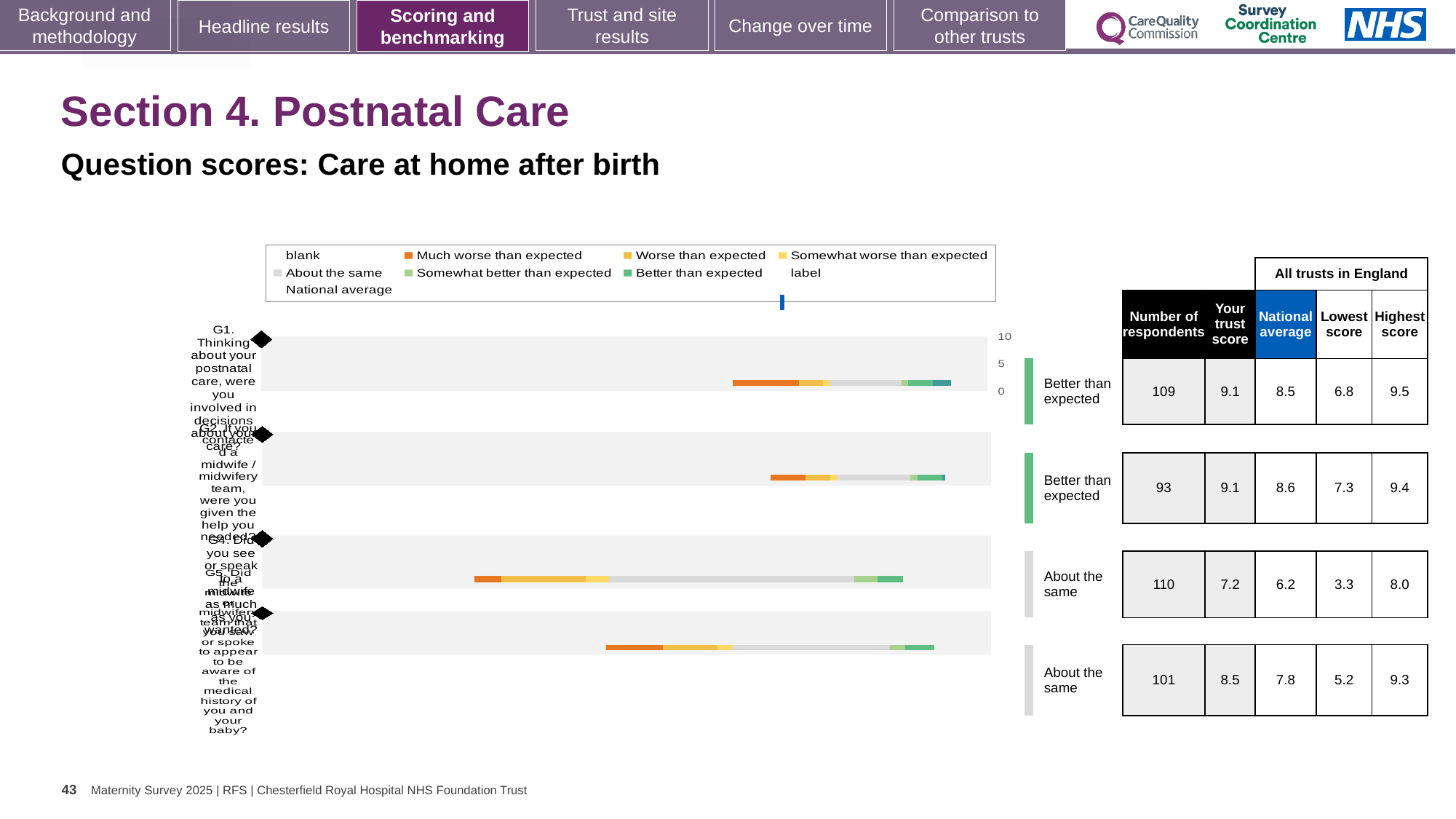
Which is larger for the fourth question row: the trust score or the national average? the trust score (8.5) What benchmark category is shown for the first two question rows? Better than expected What is the difference between the trust score and the national average for the third question row? 1.0 What kind of chart is shown on the slide? bar chart What is the lowest score across all trusts in England for the fourth (bottom) question row? 5.2 What is the difference between the highest and lowest scores for the third question row? 4.7 How many respondents are listed for the third question row? 110 What is the trust score for the first (top) question row, G1? 9.1 What is the highest score across all trusts in England for the first question row, G1? 9.5 How many question rows (bars) are plotted in the chart? 4 What is the national average for the second question row? 8.6 Which question row has the lowest trust score? the third row (7.2)